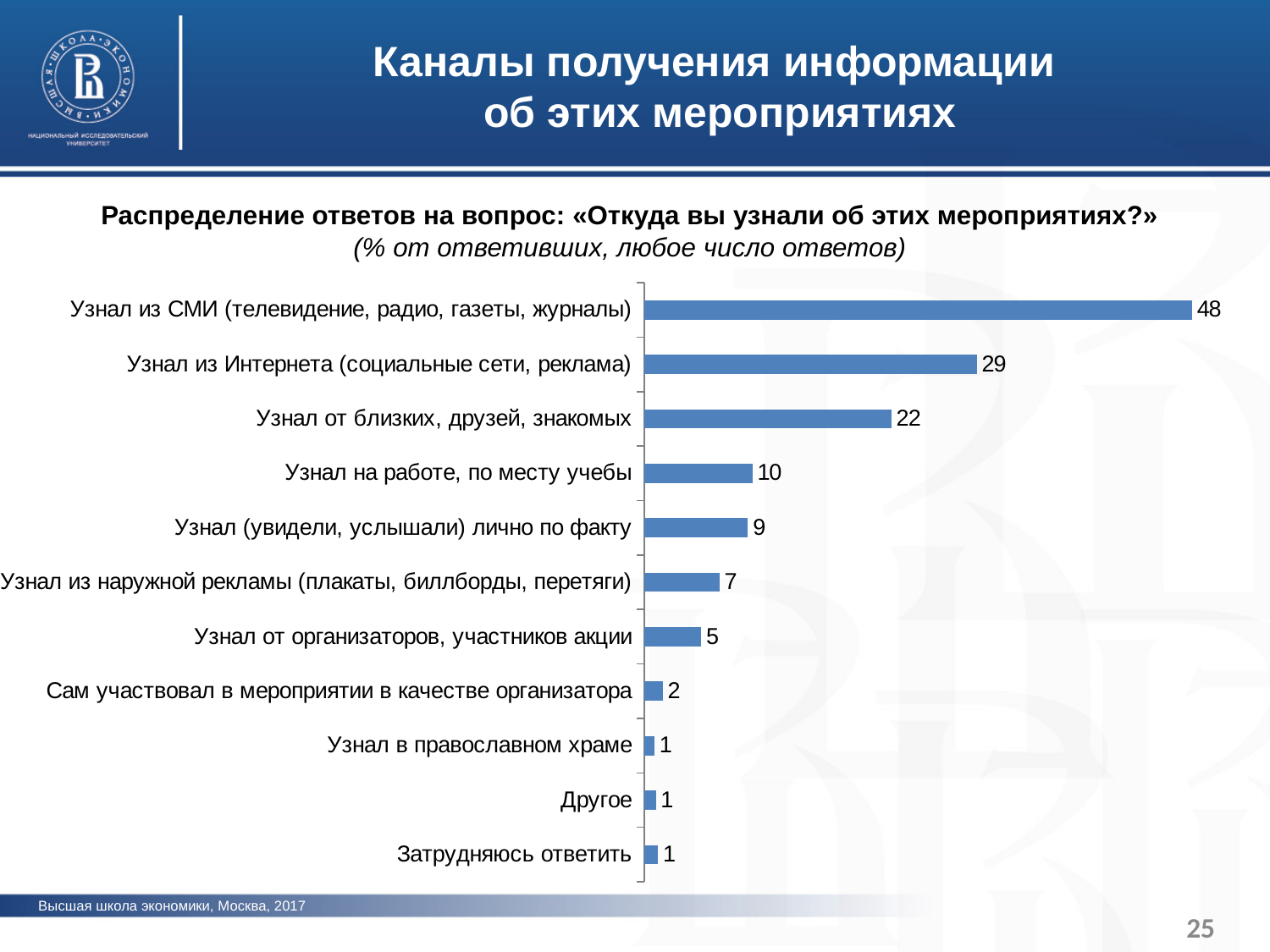
What kind of chart is shown on the slide? Bar chart Which category has the highest value? Узнал из СМИ (телевидение, радио, газеты, журналы) What is the value for «Узнал из СМИ (телевидение, радио, газеты, журналы)»? 48 What is the value for «Узнал от организаторов, участников акции»? 5 What is the value for «Узнал из Интернета (социальные сети, реклама)»? 29 What is the value for «Узнал на работе, по месту учебы»? 10 How many categories are shown in the chart? 11 What is the value for «Сам участвовал в мероприятии в качестве организатора»? 2 How many categories have a value of 1? 3 Which is larger: the value for «Узнал от близких, друзей, знакомых» or for «Узнал из наружной рекламы (плакаты, биллборды, перетяги)»? Узнал от близких, друзей, знакомых What is the difference between the values for «Узнал от близких, друзей, знакомых» and «Узнал на работе, по месту учебы»? 12 What is the difference between the values for «Узнал из СМИ (телевидение, радио, газеты, журналы)» and «Узнал из Интернета (социальные сети, реклама)»? 19